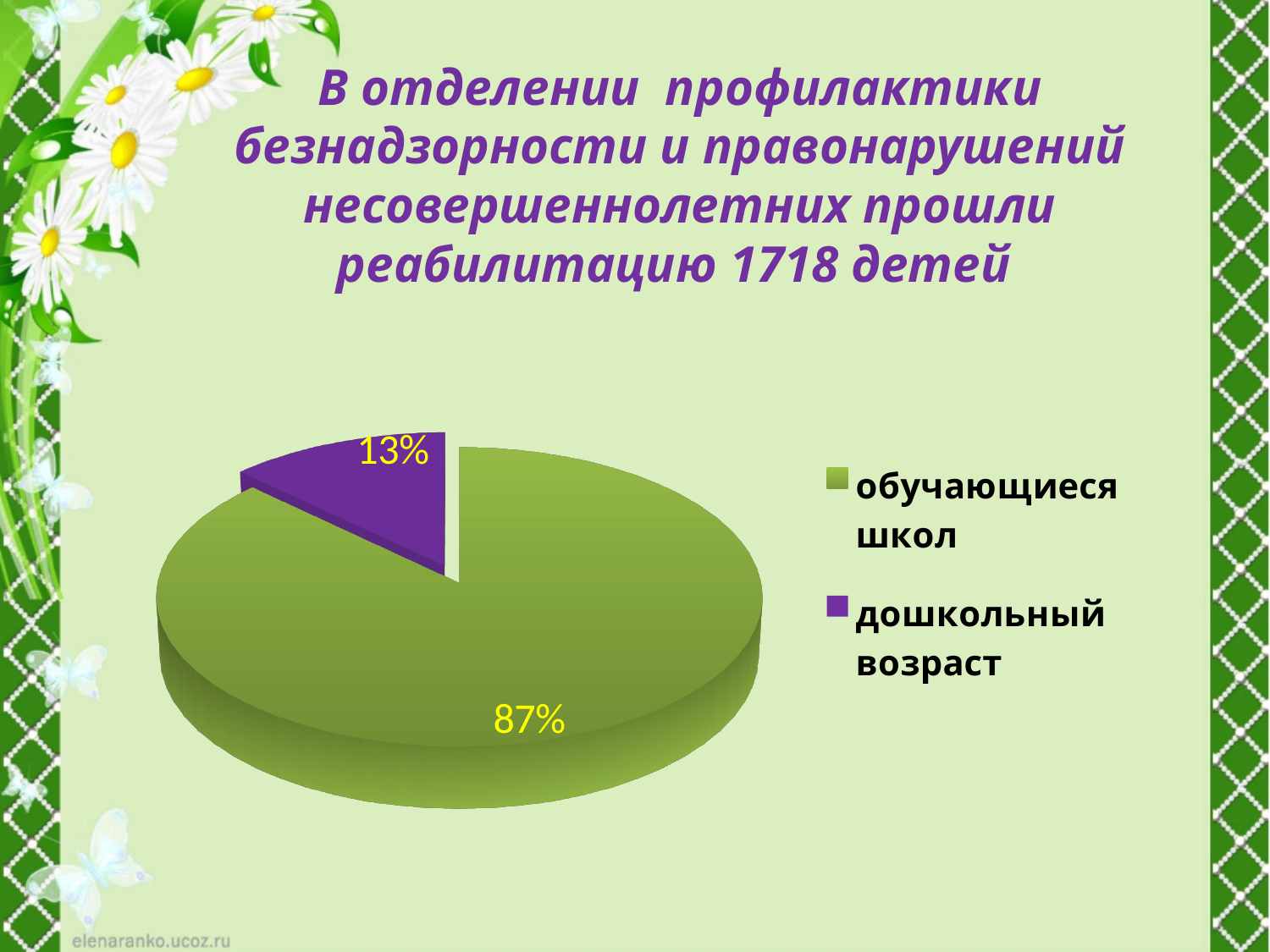
What share of the pie does "дошкольный возраст" have? 13% What share of the pie does "обучающиеся школ" have? 87% Which is larger: the slice for "обучающиеся школ" or the slice for "дошкольный возраст"? обучающиеся школ How many entries does the legend list? 2 Which category has the smallest slice of the pie? дошкольный возраст What colour is the slice for "обучающиеся школ"? green Which category has the largest slice of the pie? обучающиеся школ What colour is the slice for "дошкольный возраст"? purple What is the difference in percentage points between "обучающиеся школ" and "дошкольный возраст"? 74 How many slices does the pie chart have? 2 What is the total of the two percentages shown on the pie chart? 100% What kind of chart is shown on the slide? pie chart